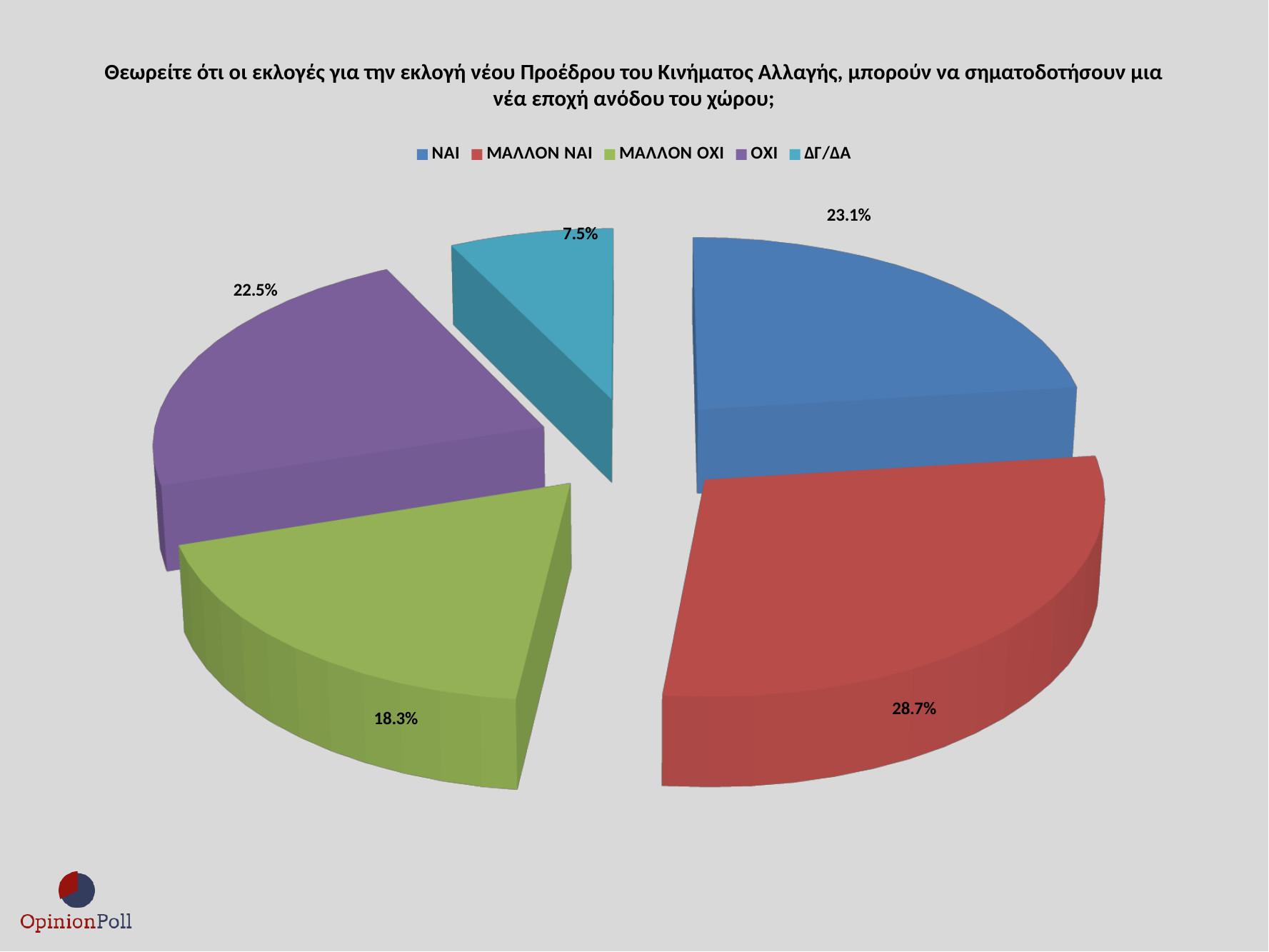
What percentage of respondents answered ΟΧΙ? 22.5% What percentage of respondents answered ΜΑΛΛΟΝ ΟΧΙ? 18.3% What percentage of respondents answered ΔΓ/ΔΑ? 7.5% What kind of chart is shown on the slide? Pie chart Which response has the largest share of the pie? ΜΑΛΛΟΝ ΝΑΙ Which colour represents ΟΧΙ in the legend? Purple What percentage of respondents answered ΝΑΙ? 23.1% What percentage of respondents answered ΜΑΛΛΟΝ ΝΑΙ? 28.7% What is the difference in percentage points between ΜΑΛΛΟΝ ΝΑΙ and ΝΑΙ? 5.6 Which response has the smallest share of the pie? ΔΓ/ΔΑ Which is larger, the share for ΟΧΙ or the share for ΜΑΛΛΟΝ ΟΧΙ? ΟΧΙ How many slices does the pie chart have? 5